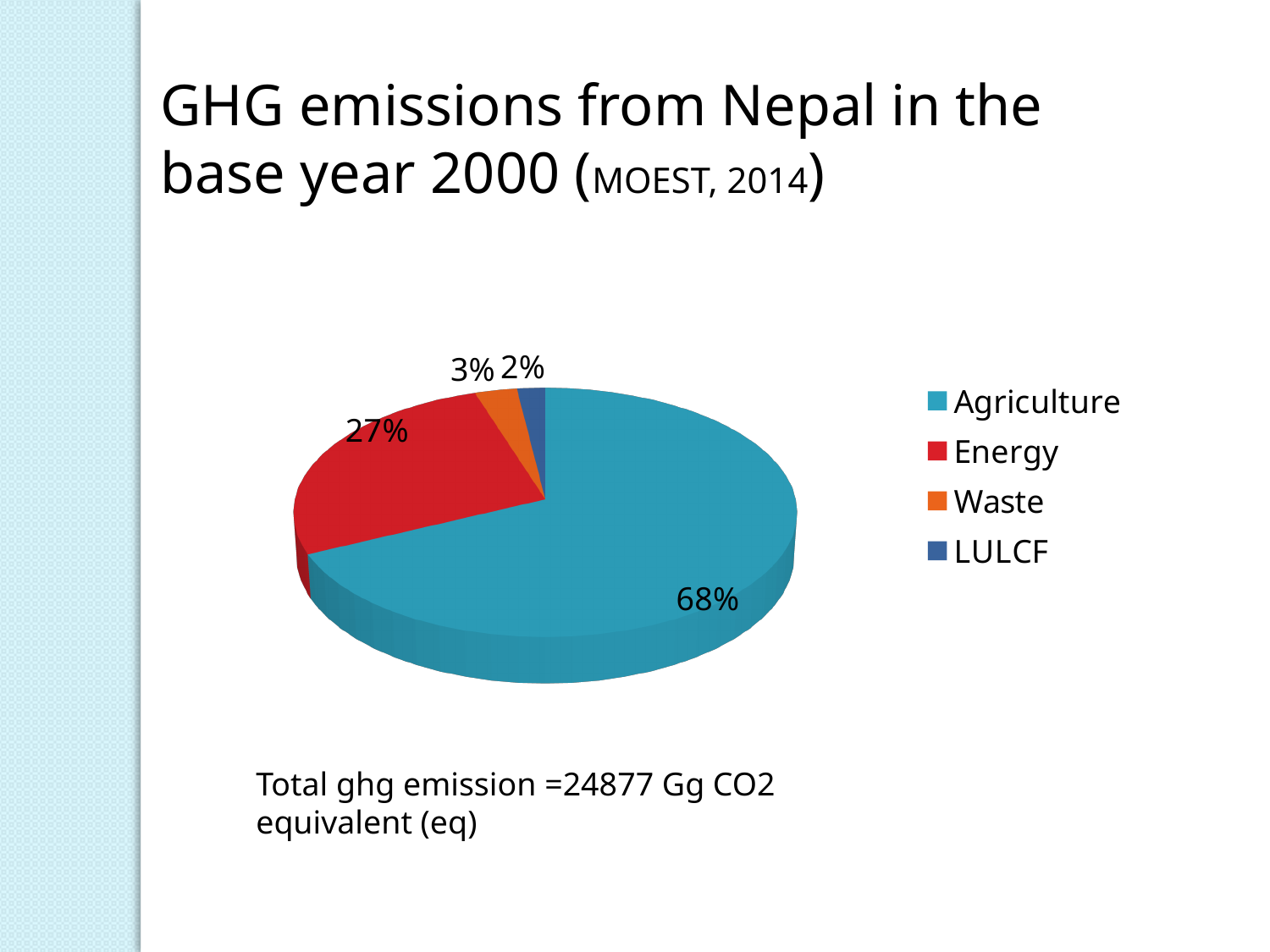
What is the total GHG emission stated below the chart? 24877 Gg CO2 equivalent (eq) Which sector has the largest share of GHG emissions? Agriculture What colour represents Energy in the pie chart? Red What percentage of emissions is attributed to LULCF? 2% What percentage of emissions comes from Energy? 27% How many sectors are shown in the pie chart? 4 Which sector has a larger share, Energy or Waste? Energy What share of GHG emissions does Agriculture account for in the pie chart? 68% What percentage of emissions is attributed to Waste? 3% Which sector has the smallest share of GHG emissions? LULCF What is the difference in percentage points between the Agriculture and Energy shares? 41 What type of chart is shown on the slide? Pie chart